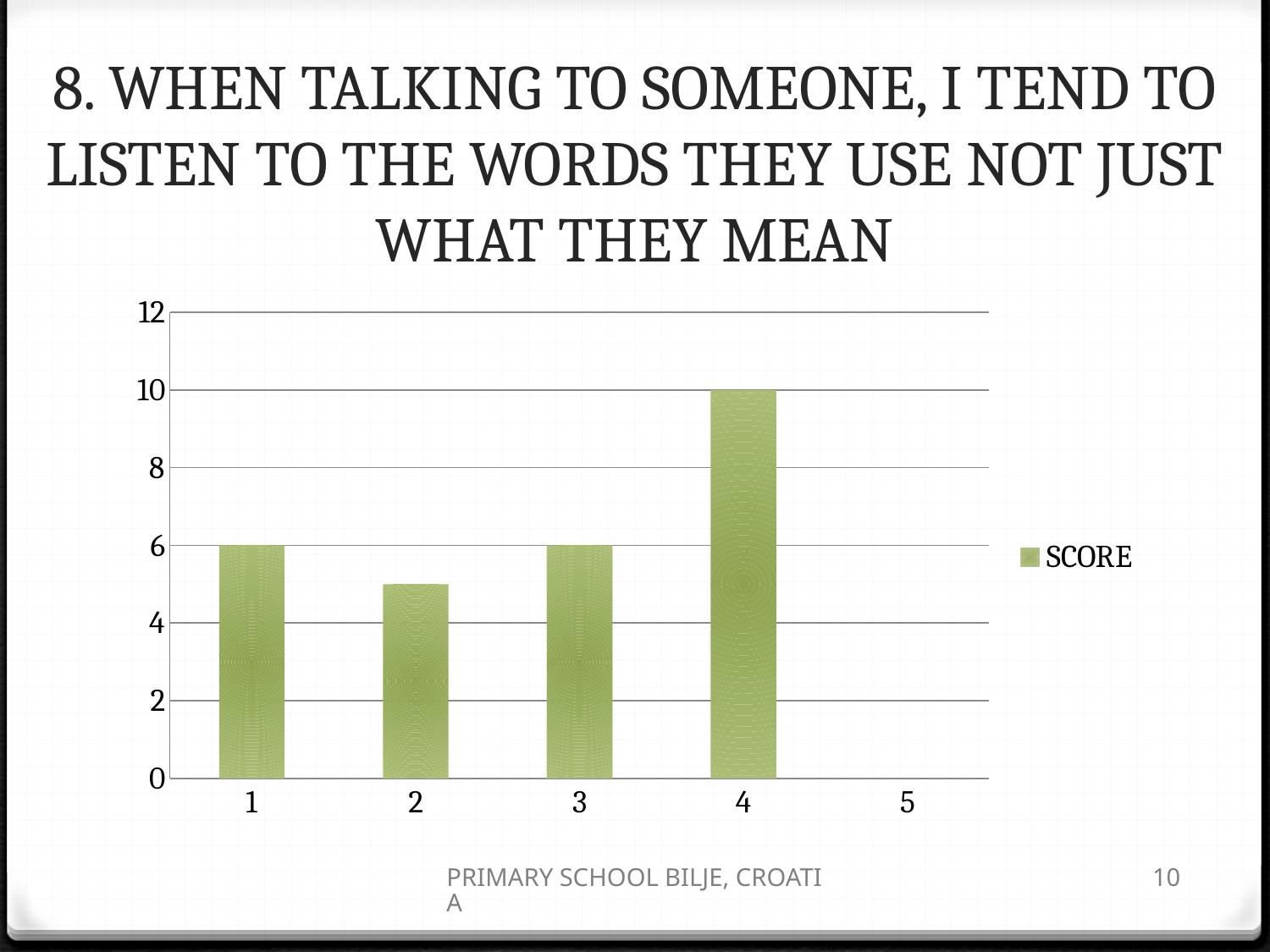
What is the value for category 1? 6 Among the categories with a visible bar, which has the lowest value? 2 What is the value for category 3? 6 Which category has the highest value? 4 What is the value for category 4? 10 Is the value for category 2 greater or less than 6? less How many categories are shown on the x axis? 5 Is the value for category 2 greater or less than 4? greater What kind of chart is shown on the slide? bar chart Which has the larger value, category 1 or category 2? 1 What is the difference between the values for category 4 and category 1? 4 How many series does the legend list? 1